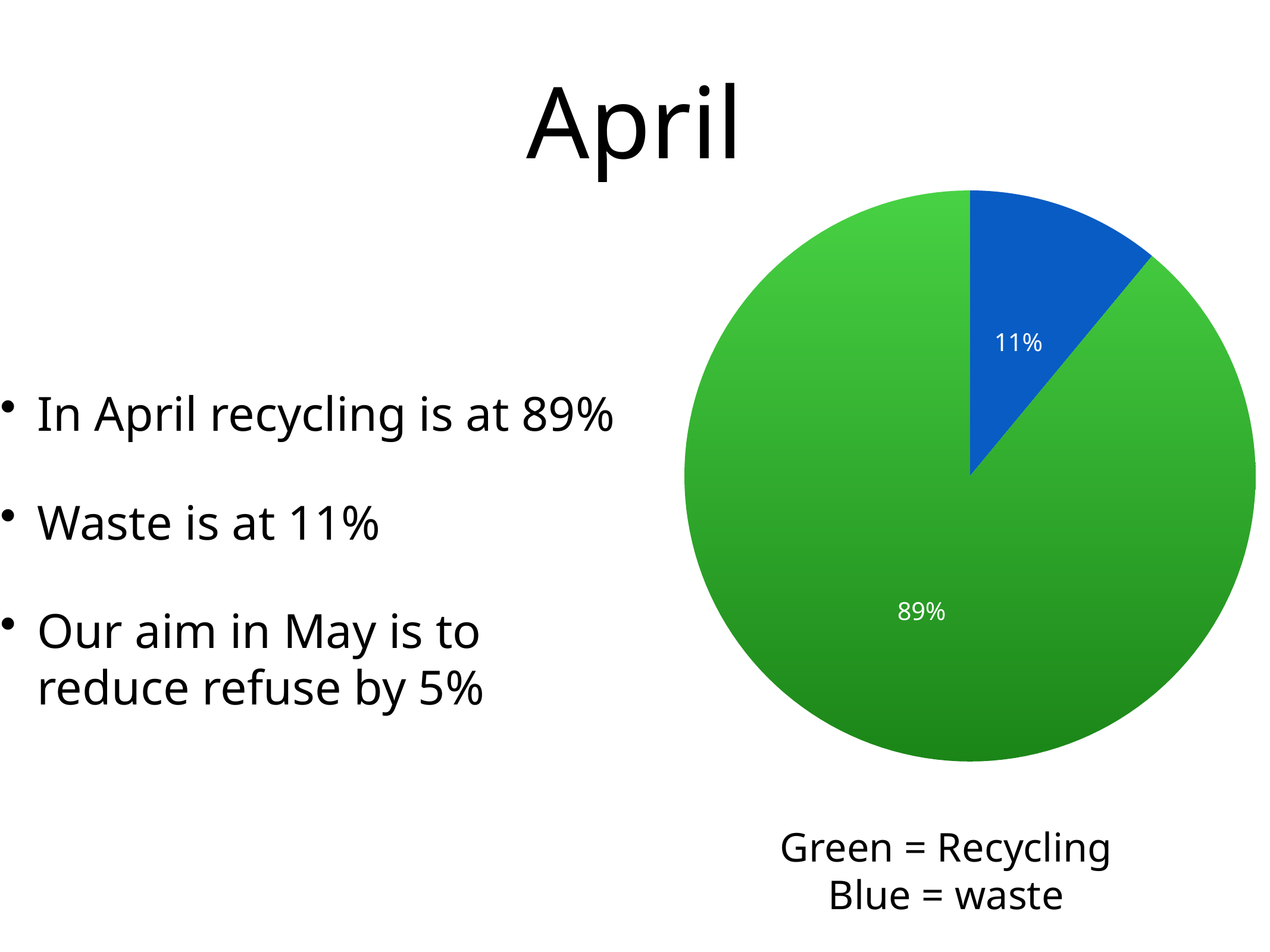
What share of the pie does Recycling (green) take? 89% What colour represents Recycling in the pie chart? Green What is the total of the two slices in the pie chart? 100% What share of the pie does waste (blue) take? 11% Which is larger, the Recycling slice or the waste slice? Recycling Which slice of the pie is the smallest? waste What is the difference between the Recycling share and the waste share? 78% What colour represents waste in the pie chart? Blue Which slice of the pie is the largest? Recycling How many slices does the pie chart have? 2 What kind of chart is shown on the slide? pie chart